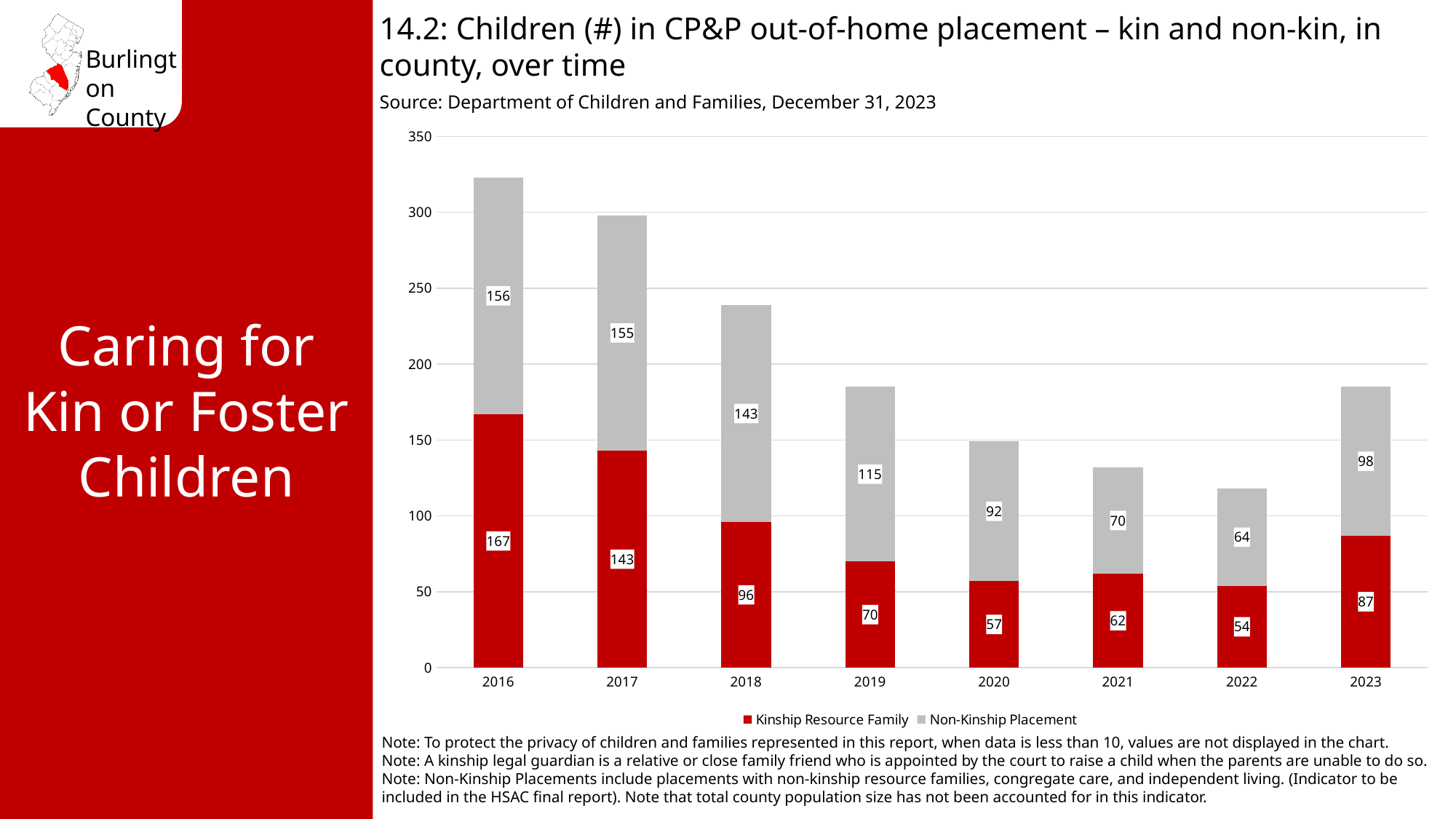
What is the total of the stacked bar for 2020? 149 How many years are shown on the x axis? 8 Which year has the highest Non-Kinship Placement value? 2016 How many series does the legend list? 2 Which is larger, the Kinship Resource Family value for 2021 or for 2020? 2021 What kind of chart is shown on the slide? Stacked bar chart What is the Kinship Resource Family value for 2016? 167 What is the total of the stacked bar for 2016? 323 Which year has the lowest Kinship Resource Family value? 2022 What is the Kinship Resource Family value for 2023? 87 What is the Non-Kinship Placement value for 2019? 115 What is the difference between the Non-Kinship Placement values for 2018 and 2022? 79